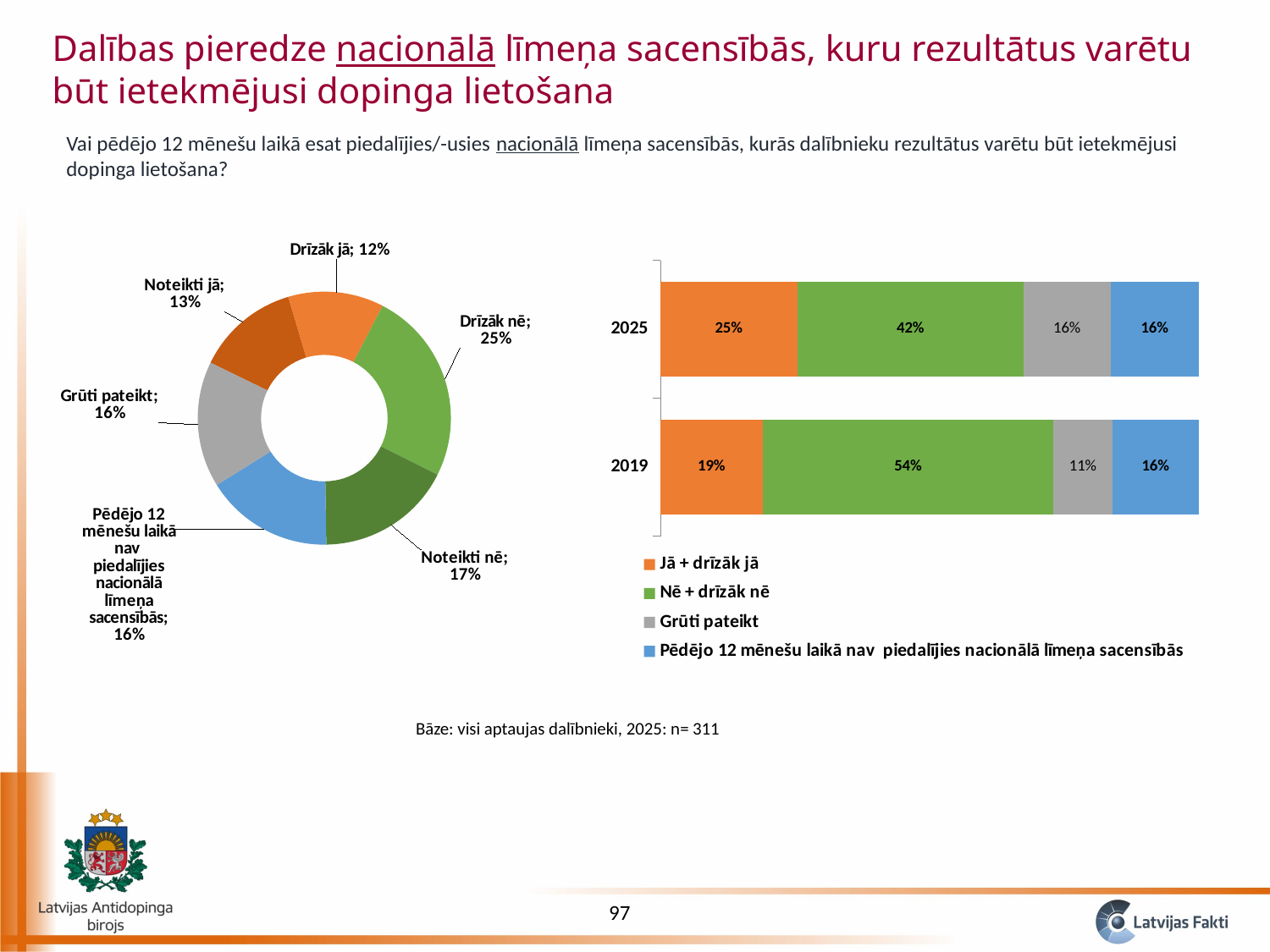
In the stacked bar chart on the right, how many series does the legend list? 4 In the stacked bar chart on the right, what is the value for "Jā + drīzāk jā" in 2025? 25% In the stacked bar chart on the right, which year has the larger value for "Nē + drīzāk nē", 2025 or 2019? 2019 In the donut chart on the left, what is the value for "Drīzāk nē"? 25% In the stacked bar chart on the right, what is the value for "Nē + drīzāk nē" in 2019? 54% What type of chart is shown on the right side of the slide? Stacked bar chart In the donut chart on the left, which category has the highest value? Drīzāk nē In the donut chart on the left, what is the value for "Noteikti jā"? 13% In the donut chart on the left, what is the difference between "Drīzāk nē" and "Noteikti nē"? 8% In the donut chart on the left, which category has the lowest value? Drīzāk jā In the donut chart on the left, how many categories are shown? 6 In the stacked bar chart on the right, what is the value for "Grūti pateikt" in 2019? 11%